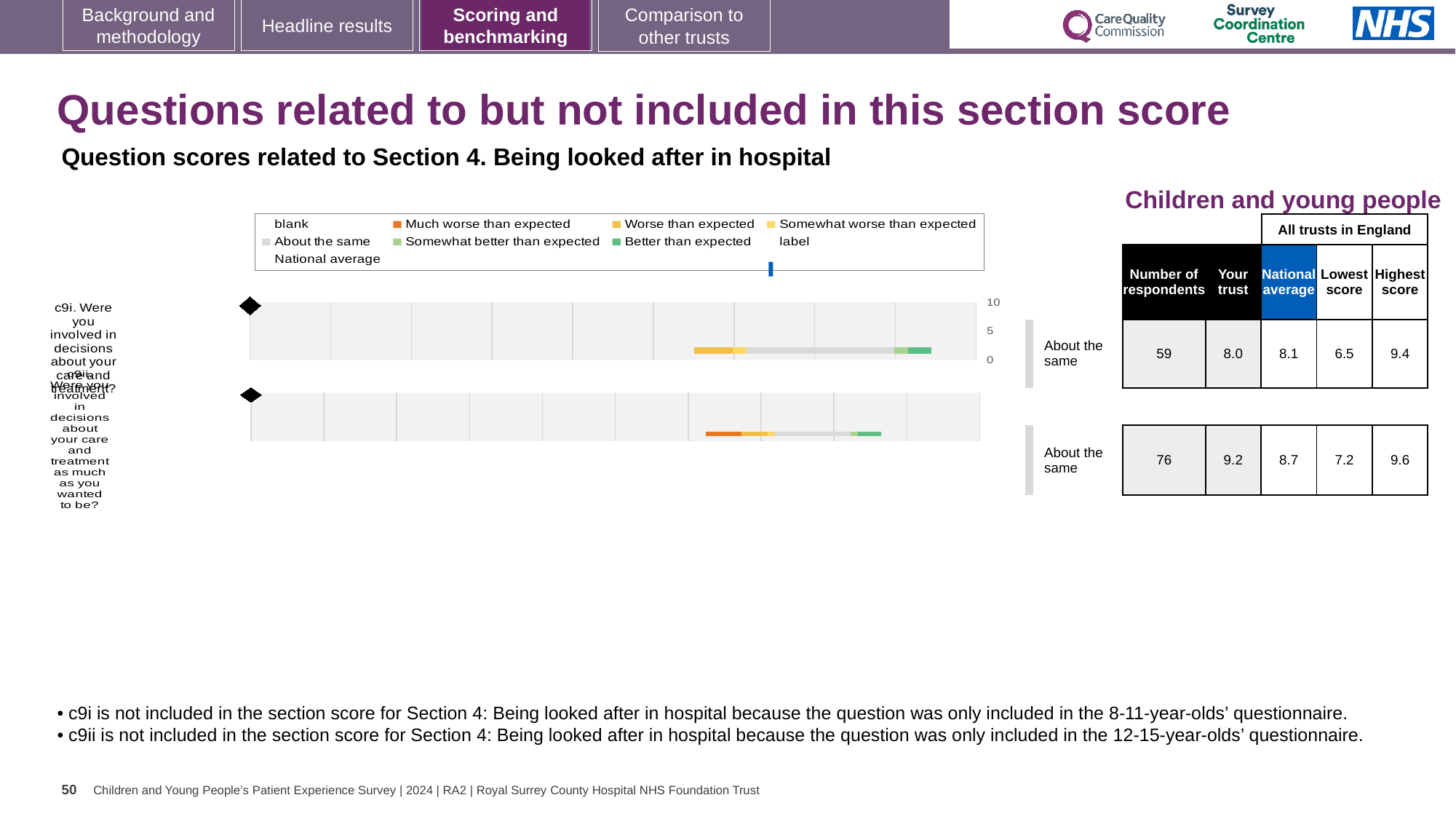
What is the 'Your trust' score for question c9ii? 9.2 How many respondents answered question c9i? 59 Which question has the higher 'Your trust' score, c9i or c9ii? c9ii Is the 'Your trust' score for question c9i greater or less than 5 on the chart axis? greater For question c9ii, is the 'Your trust' score or the national average larger? Your trust What benchmark category is shown next to the bar for question c9i? About the same What is the highest score across all trusts in England for question c9i? 9.4 What is the 'Your trust' score for question c9i? 8.0 How many questions (bars) are plotted in the chart? 2 What kind of chart is used to show the question scores on this slide? bar chart What is the national average score for question c9ii? 8.7 What is the difference between the 'Your trust' score and the national average for question c9ii? 0.5